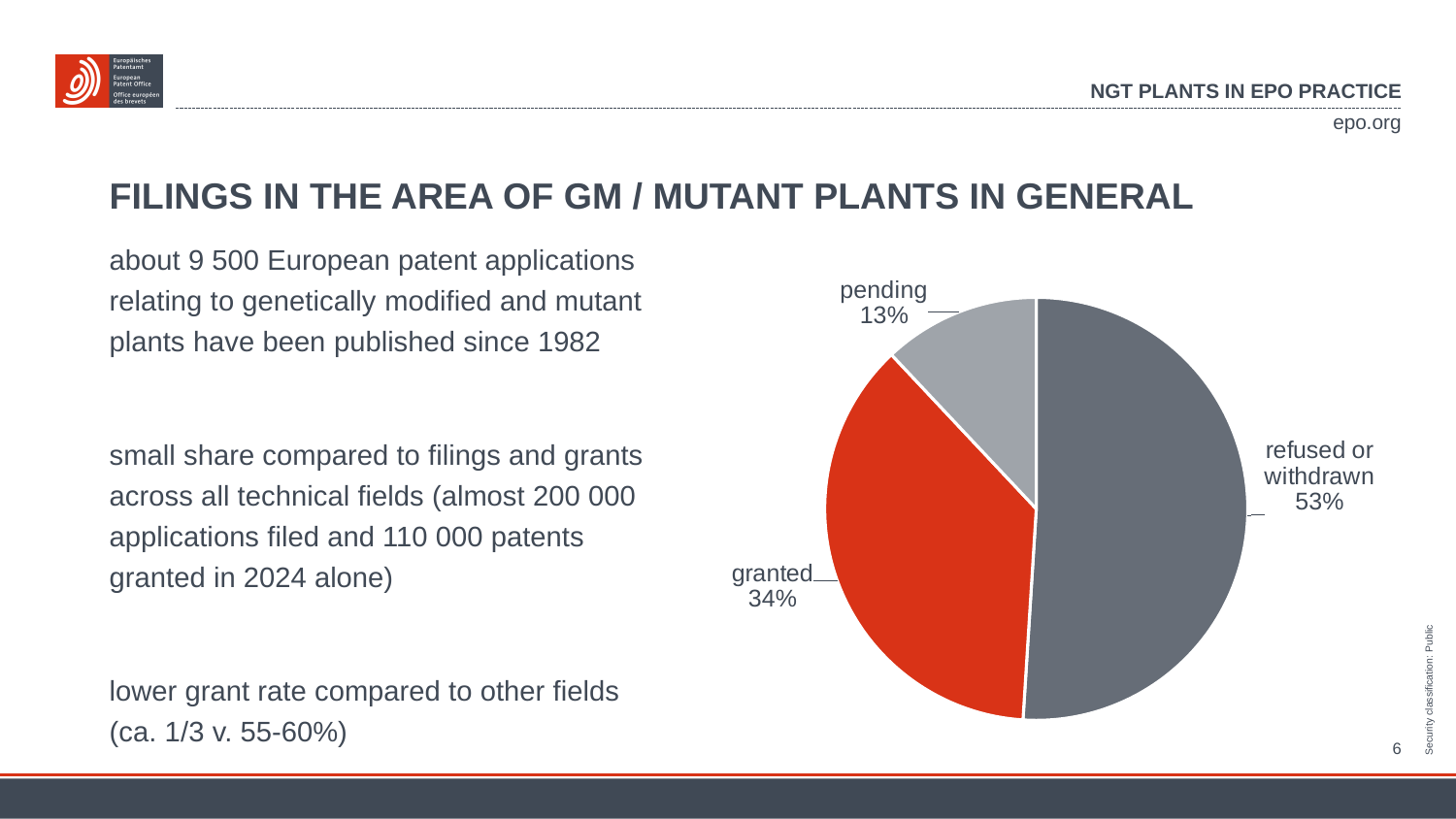
What share of the pie does the 'refused or withdrawn' slice represent? 53% Is the share for 'refused or withdrawn' greater or less than 50%? greater What share of the pie does the 'pending' slice represent? 13% What colour is the 'granted' slice of the pie chart? red What share of the pie does the 'granted' slice represent? 34% What kind of chart is shown on the slide? pie chart Which slice of the pie chart is the smallest? pending Which slice of the pie chart is the largest? refused or withdrawn What is the difference in percentage points between the 'granted' slice and the 'pending' slice? 21 Which is larger, the 'granted' slice or the 'pending' slice? granted How many slices does the pie chart have? 3 What is the difference in percentage points between the 'refused or withdrawn' slice and the 'granted' slice? 19